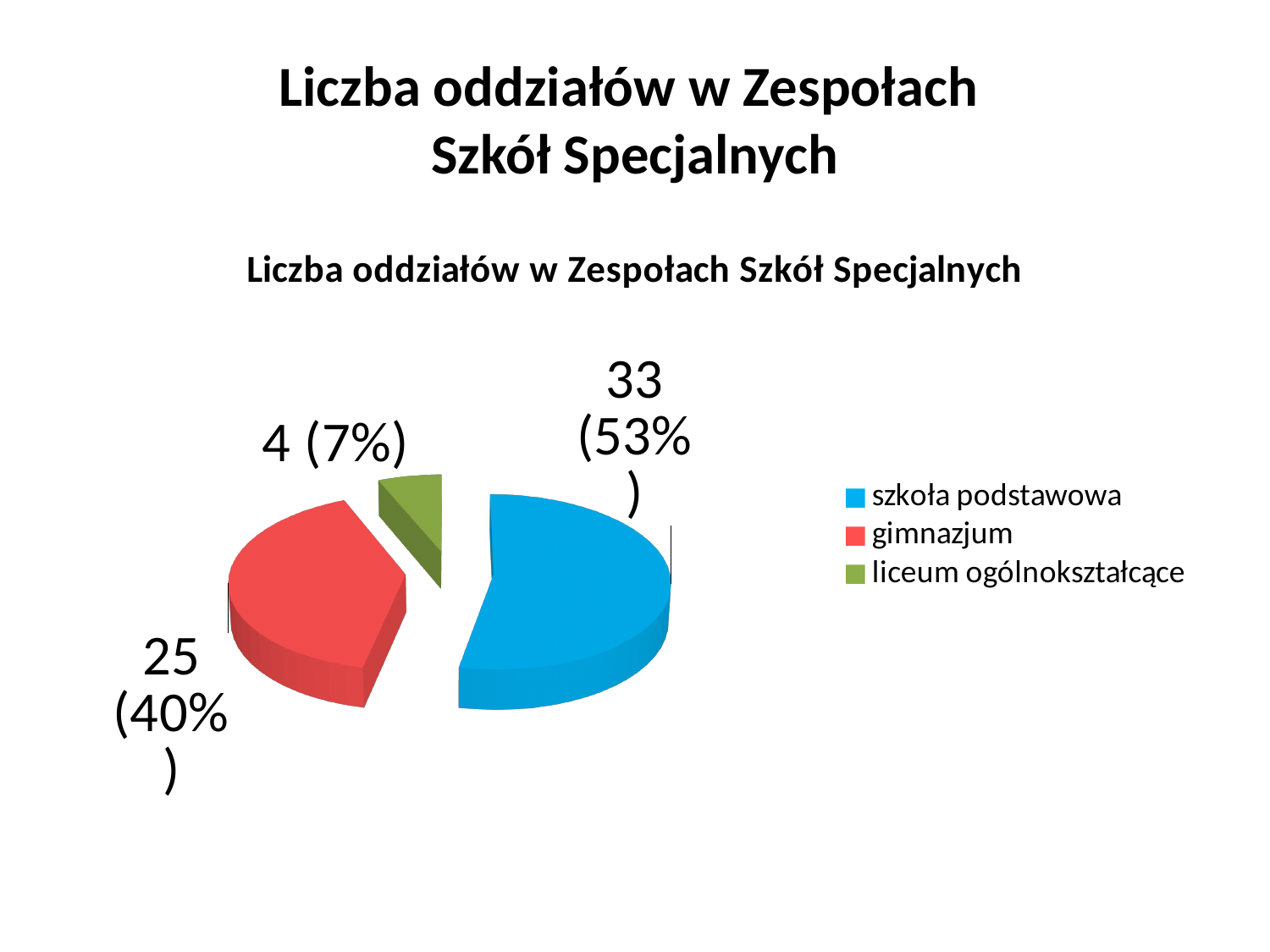
What is the value for liceum ogólnokształcące? 4 What share of the pie does gimnazjum represent? 40% How many categories does the legend list? 3 What share of the pie does szkoła podstawowa represent? 53% What is the difference between the values for szkoła podstawowa and gimnazjum? 8 What kind of chart is shown on the slide? pie chart How many slices does the pie chart have? 3 What is the value for gimnazjum? 25 What is the value for szkoła podstawowa? 33 Which category has the largest slice? szkoła podstawowa What is the title of the chart? Liczba oddziałów w Zespołach Szkół Specjalnych Which category has the smallest slice? liceum ogólnokształcące